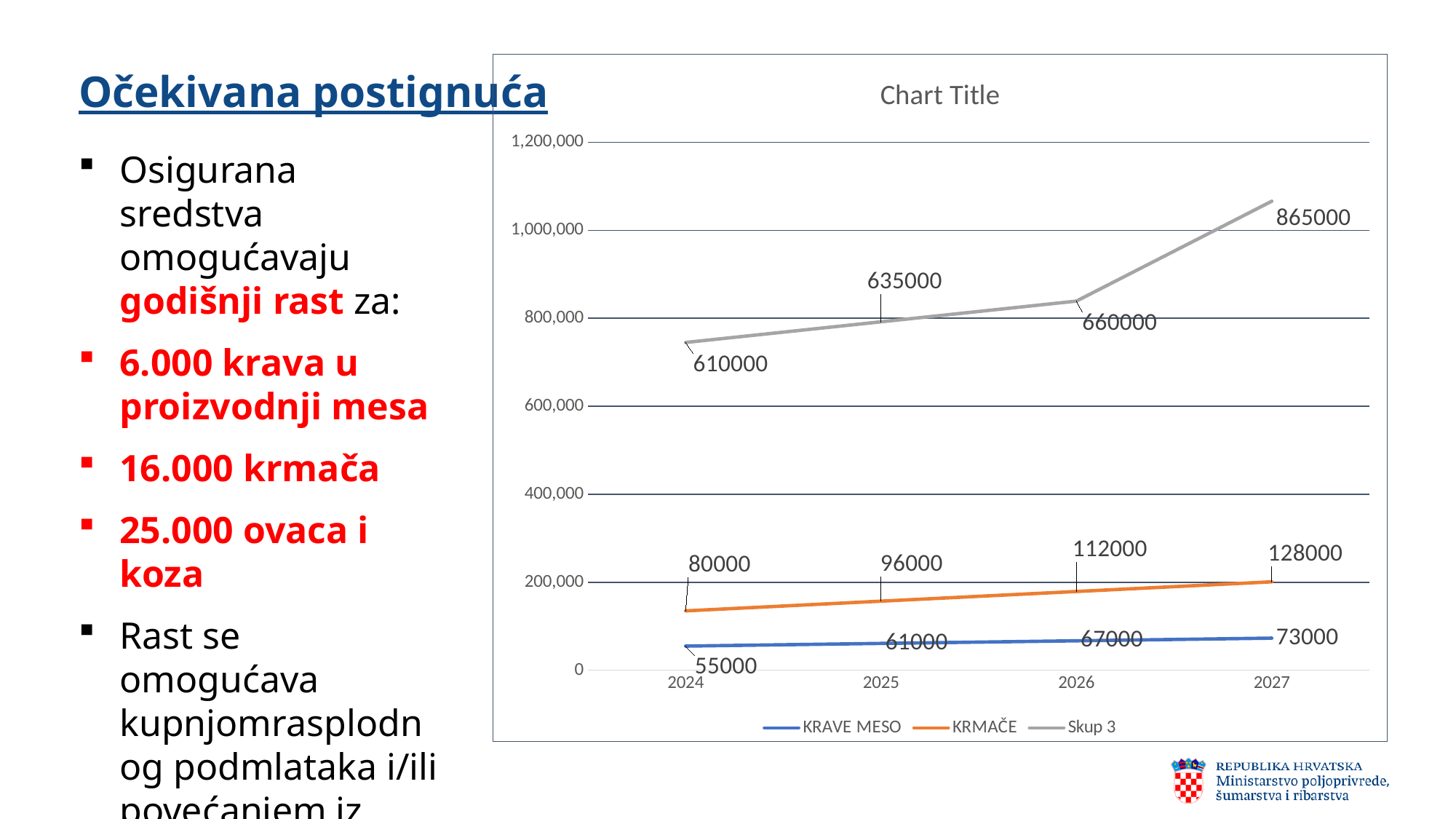
Do the values for KRAVE MESO rise or fall from 2024 to 2027? rise What is the title shown on the chart? Chart Title In which year is the value for KRAVE MESO lowest? 2024 What kind of chart is shown on the slide? line chart What is the value for Skup 3 in 2024? 610000 What is the difference between the KRMAČE values for 2027 and 2024? 48000 What is the value for KRMAČE in 2025? 96000 How many series does the chart legend list? 3 How many years are shown on the x axis of the chart? 4 Which is larger in 2026, the value for KRMAČE or the value for KRAVE MESO? KRMAČE In which year is the value for Skup 3 highest? 2027 What is the value for KRAVE MESO in 2027? 73000